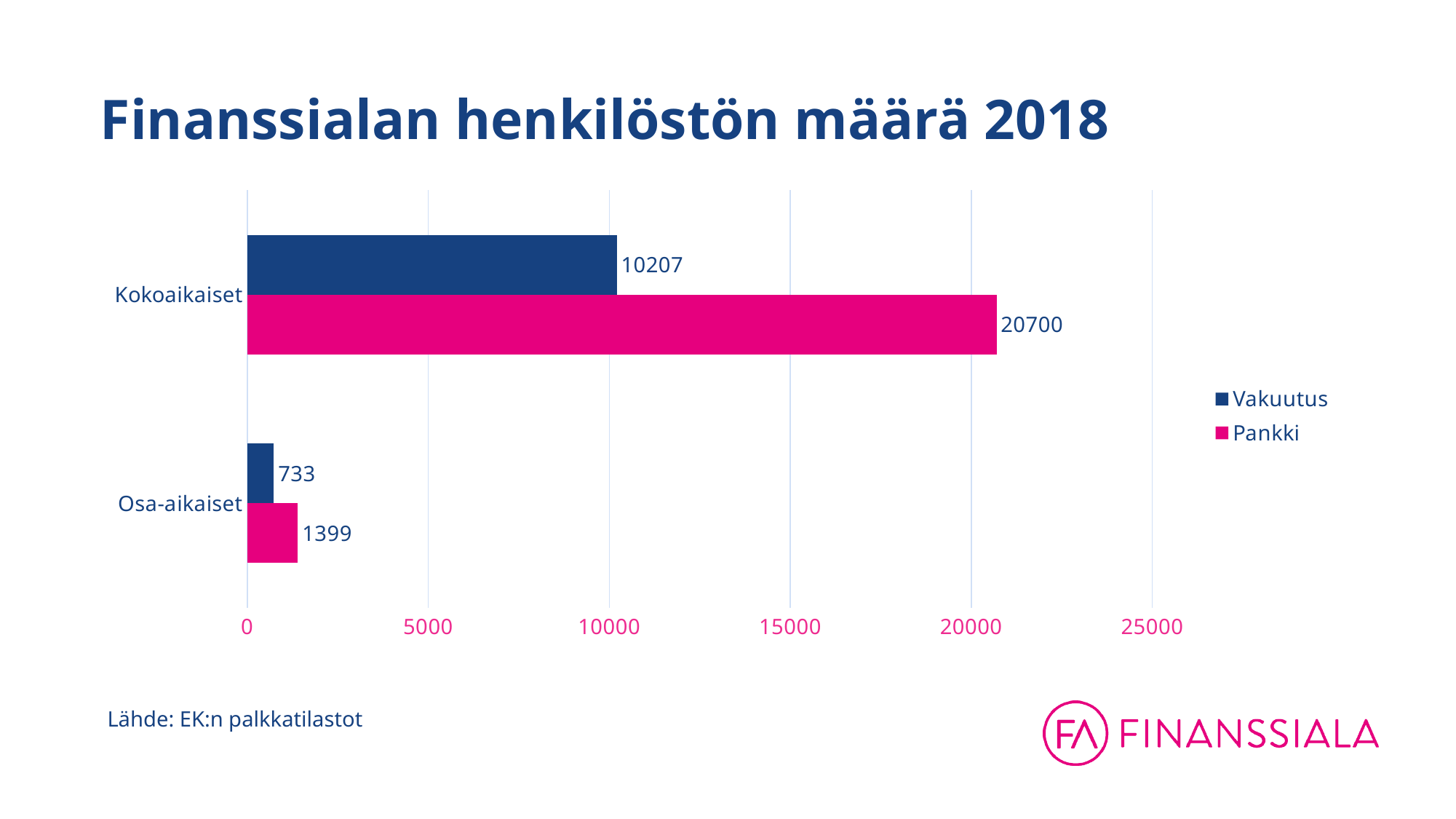
Which is larger: Vakuutus for Kokoaikaiset or Pankki for Osa-aikaiset? Vakuutus for Kokoaikaiset What kind of chart is shown on the slide? Bar chart Which series has the highest value in the Kokoaikaiset category? Pankki What is the difference between the Pankki and Vakuutus values for Kokoaikaiset? 10493 What is the difference between the Pankki and Vakuutus values for Osa-aikaiset? 666 How many series does the legend list? 2 What is the value for Pankki in the Osa-aikaiset category? 1399 How many categories are shown on the chart? 2 What is the value for Vakuutus in the Kokoaikaiset category? 10207 What is the value for Vakuutus in the Osa-aikaiset category? 733 What is the value for Pankki in the Kokoaikaiset category? 20700 Which bar has the lowest value on the chart? Vakuutus, Osa-aikaiset